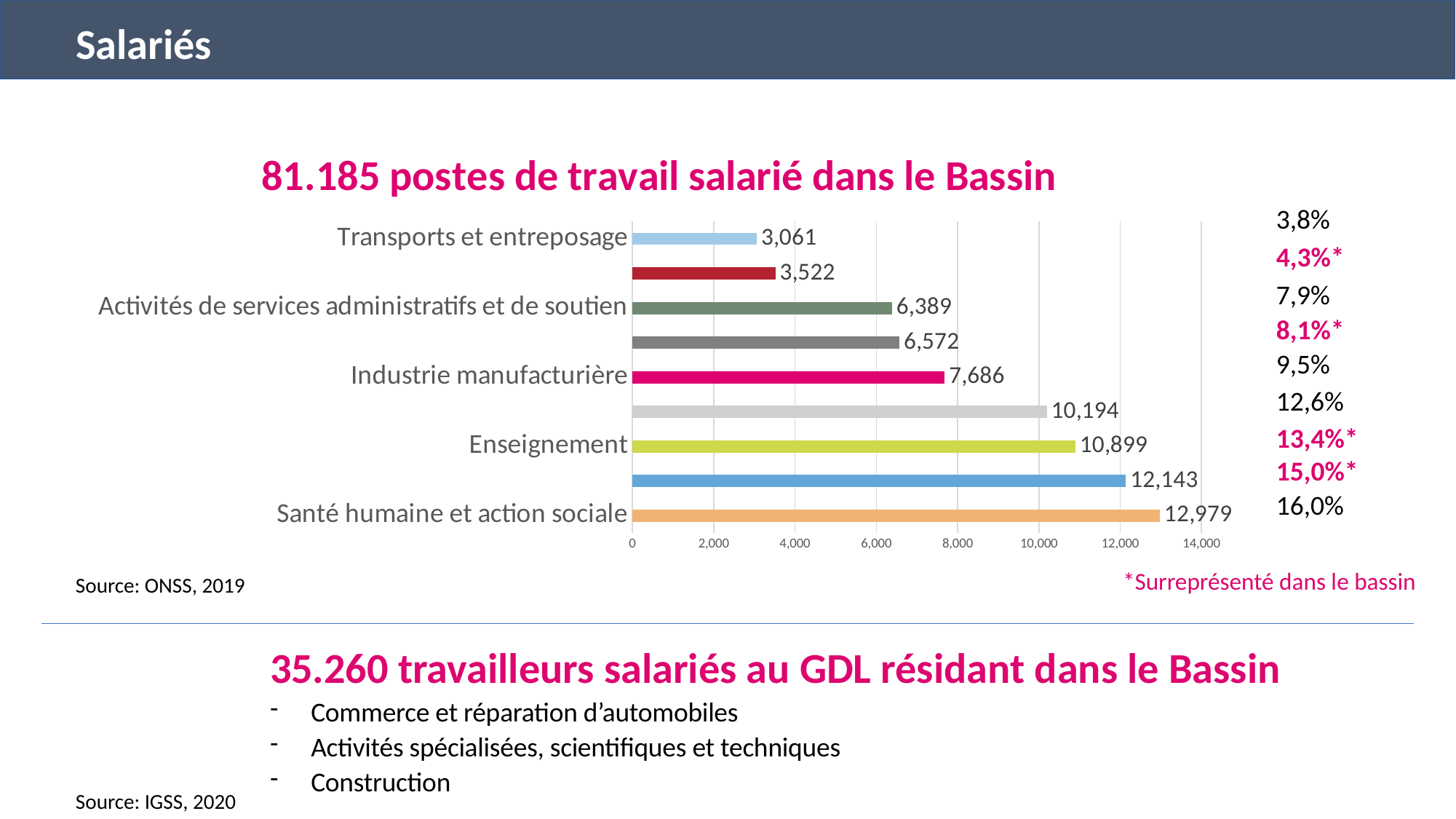
What is the value for Santé humaine et action sociale? 12,979 Which labelled category has the highest value? Santé humaine et action sociale What is the value for Enseignement? 10,899 Which labelled category has the lowest value? Transports et entreposage What is the value for Activités de services administratifs et de soutien? 6,389 Which is larger, the value for Industrie manufacturière or the value for Activités de services administratifs et de soutien? Industrie manufacturière What is the difference between the values for Santé humaine et action sociale and Enseignement? 2,080 What is the value for Transports et entreposage? 3,061 What is the difference between the values for Enseignement and Industrie manufacturière? 3,213 What is the value for Industrie manufacturière? 7,686 How many bars are plotted in the chart? 9 What kind of chart is shown on the slide? Bar chart